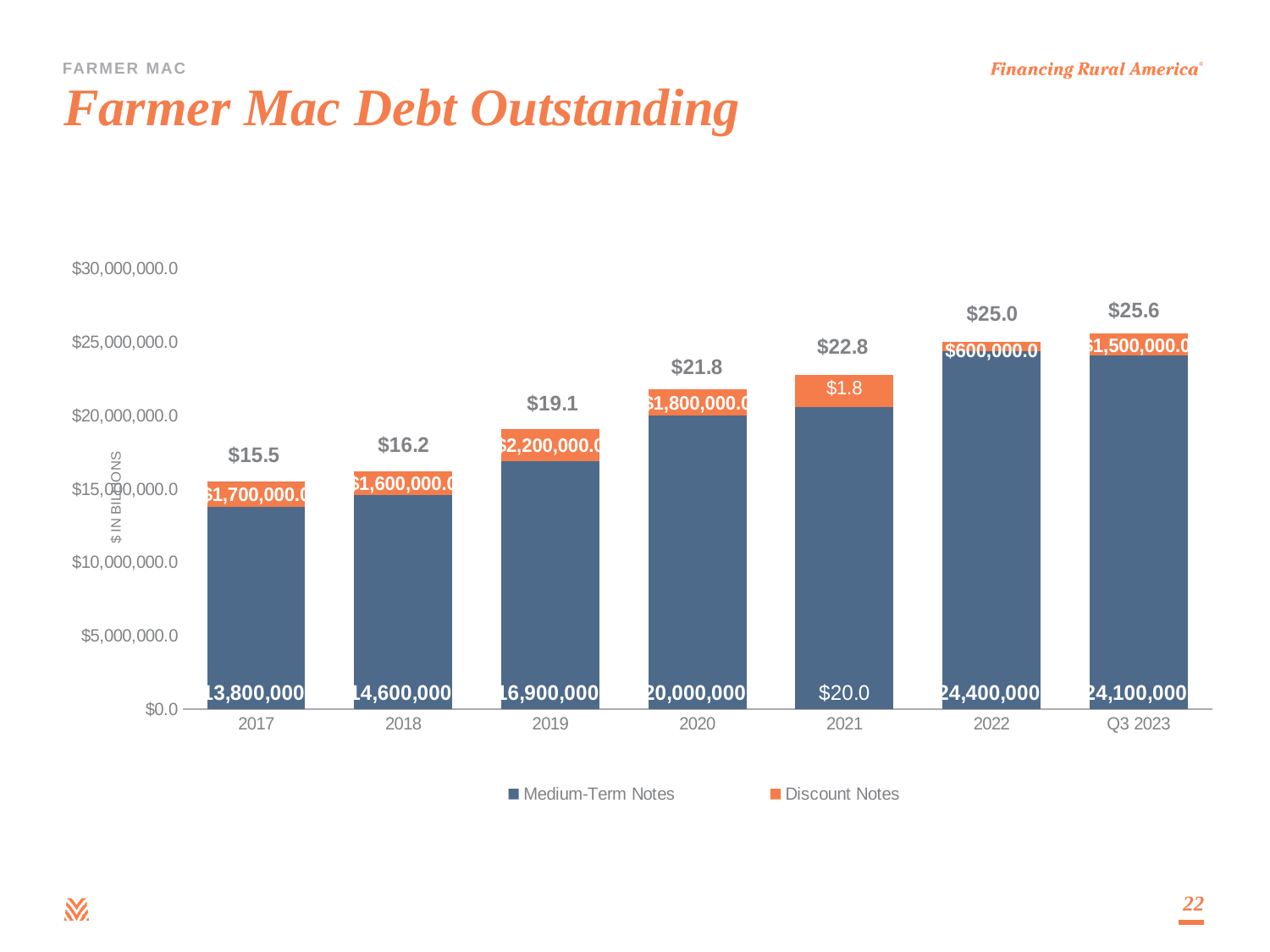
What is the total debt outstanding labeled above the 2020 bar? $21.8 Is the Medium-Term Notes value for 2017 greater or less than $15,000,000.0? less What is the difference between the total labeled for Q3 2023 and the total labeled for 2017? $10.1 Do the total debt outstanding values rise or fall from 2017 to Q3 2023? Rise How many series does the legend list? 2 What kind of chart is shown on the slide? Stacked bar chart Which period has a larger total debt outstanding, 2018 or 2019? 2019 Which period has the lowest total debt outstanding? 2017 Which period has the highest total debt outstanding? Q3 2023 How many periods are shown along the x axis? 7 What is the Discount Notes value labeled for 2021? $1.8 What is the total debt outstanding labeled above the 2022 bar? $25.0